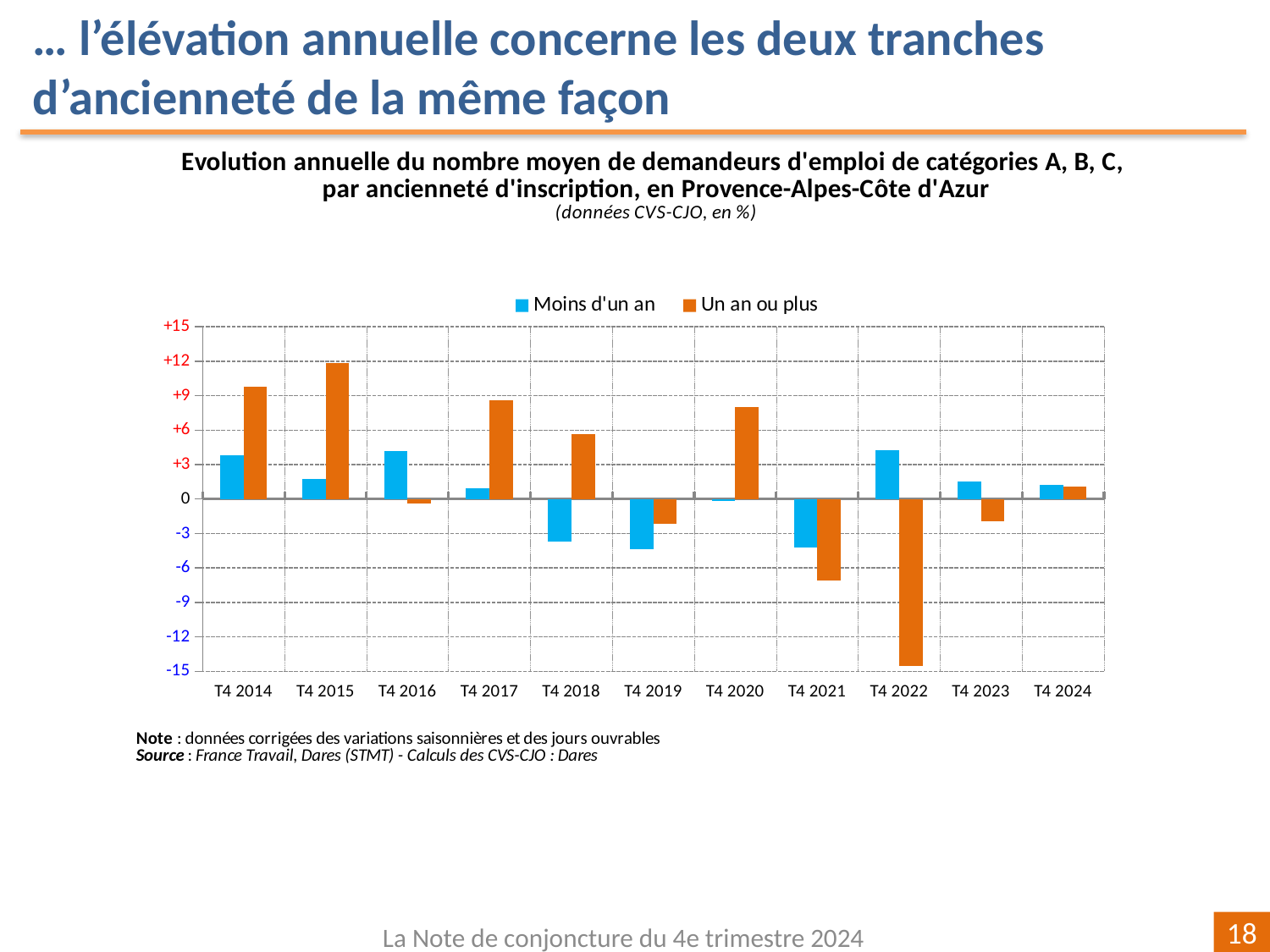
For the series 'Un an ou plus', which quarter has the highest value? T4 2015 What kind of chart is shown on the slide? bar chart For the series 'Un an ou plus', which quarter has the lowest value? T4 2022 Is the value for 'Moins d'un an' in T4 2018 greater or less than -3? less Is the value for 'Un an ou plus' in T4 2022 greater or less than -12? less Is the value for 'Un an ou plus' in T4 2015 greater or less than +9? greater How many series does the legend list? 2 In T4 2021, which series has the larger value, 'Moins d'un an' or 'Un an ou plus'? Moins d'un an How many quarters (categories) are shown on the x axis? 11 In T4 2014, which series has the larger value, 'Moins d'un an' or 'Un an ou plus'? Un an ou plus Which colour represents the series 'Un an ou plus' in the legend? orange